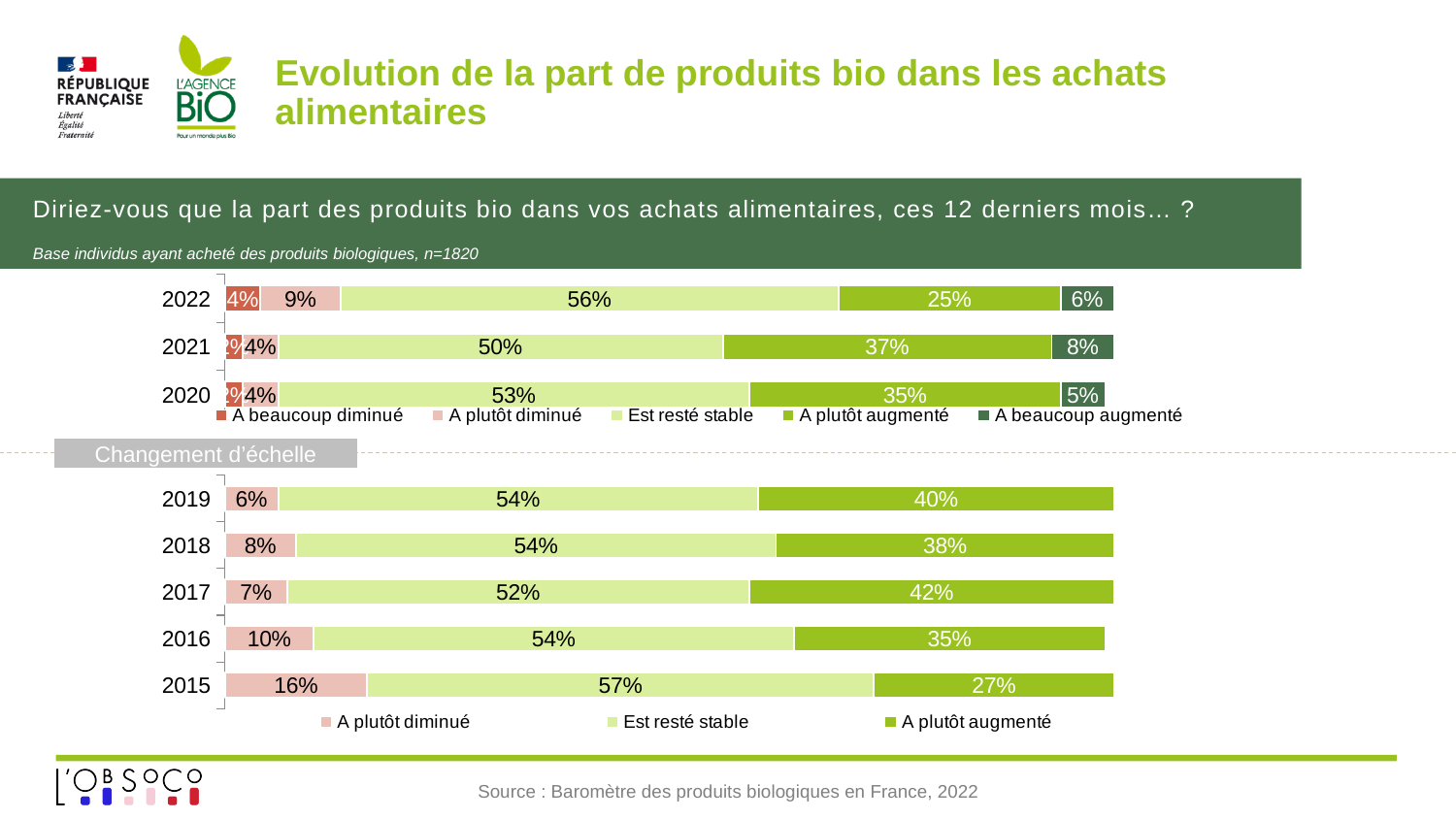
In the bottom chart (2015–2019), which year has the highest share for "A plutôt augmenté"? 2017 In the bottom chart (2015–2019), which year has the lowest share for "A plutôt diminué"? 2019 In the bottom chart (2015–2019), what percentage answered "A plutôt diminué" in 2015? 16% What type of chart is used on this slide? Stacked bar chart In the top chart (2020–2022), which year has the highest share for "A plutôt diminué"? 2022 In the bottom chart (2015–2019), is the "Est resté stable" share larger in 2015 or in 2017? 2015 In the top chart (2020–2022), how many series does the legend list? 5 In the top chart (2020–2022), what percentage answered "Est resté stable" in 2022? 56% In the top chart (2020–2022), what is the difference between the "A plutôt augmenté" shares for 2021 and 2022? 12 percentage points In the bottom chart (2015–2019), how many years are shown? 5 In the top chart (2020–2022), what percentage answered "A plutôt augmenté" in 2021? 37% In the top chart (2020–2022), what percentage answered "A beaucoup augmenté" in 2020? 5%